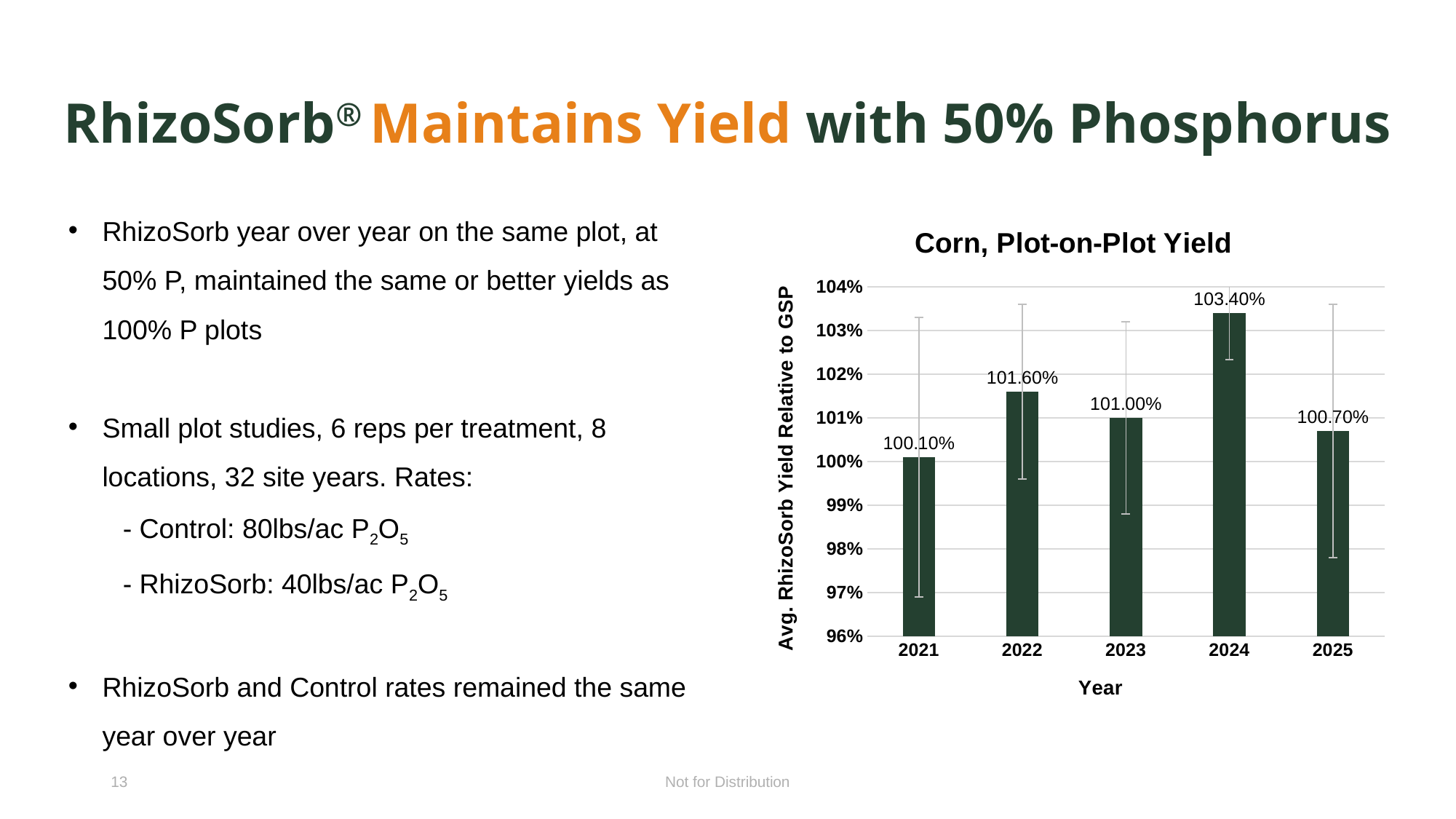
Which year has the highest value? 2024 What is the label of the y axis? Avg. RhizoSorb Yield Relative to GSP What is the title of the chart? Corn, Plot-on-Plot Yield Which is larger, the value for 2023 or the value for 2025? 2023 What is the value for 2025? 100.70% What is the value for 2024? 103.40% Which year has the lowest value? 2021 What kind of chart is this? bar chart What is the value for 2021? 100.10% What is the difference between the values for 2024 and 2022? 1.80% How many years are shown on the x axis? 5 Is the value for 2022 greater or less than 101%? greater